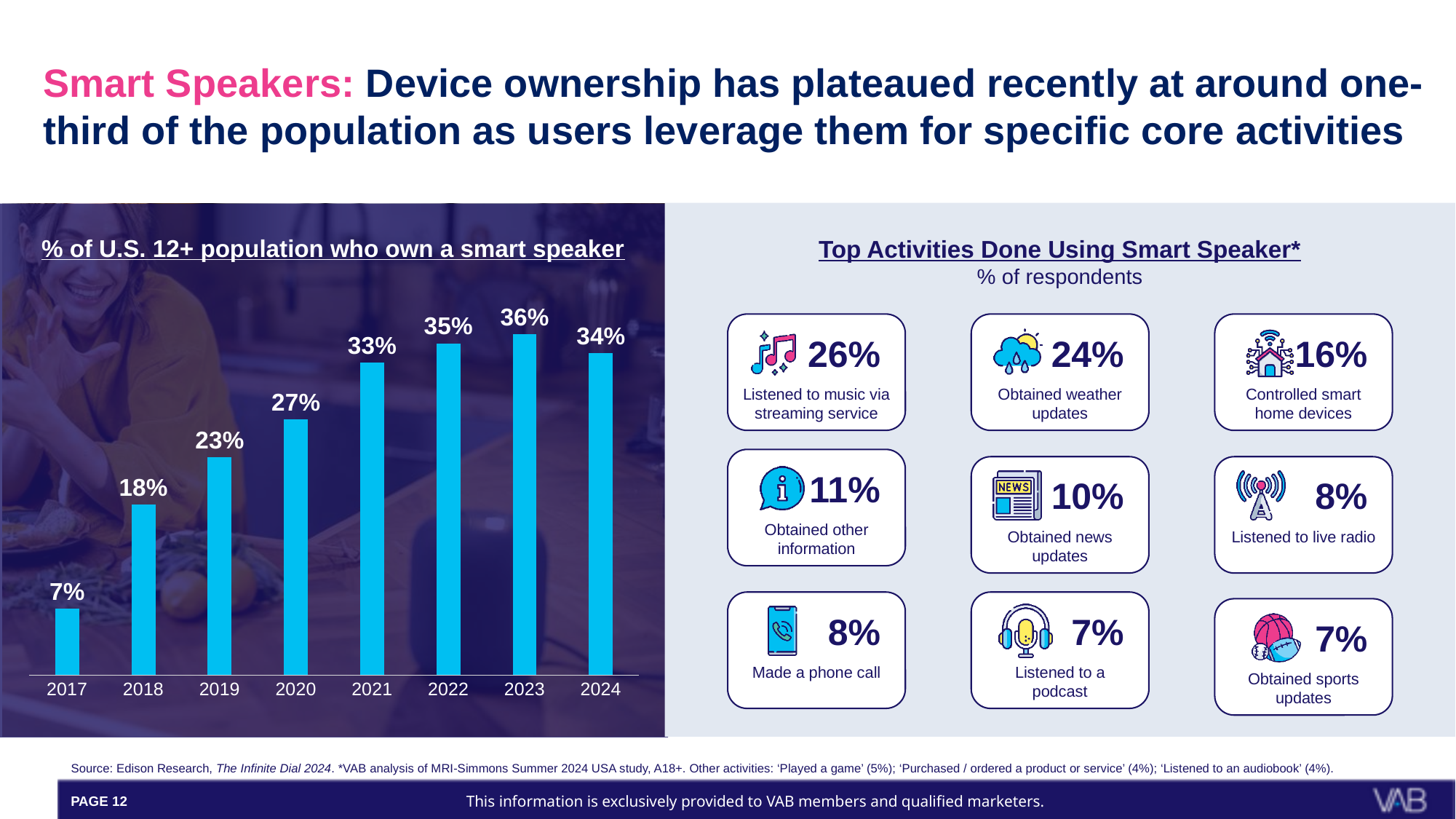
What colour are the bars in the chart '% of U.S. 12+ population who own a smart speaker'? Light blue In the chart '% of U.S. 12+ population who own a smart speaker', what is the difference between the 2018 and 2019 values? 5% In the chart '% of U.S. 12+ population who own a smart speaker', what is the difference between the 2023 and 2017 values? 29% How many years are shown in the chart '% of U.S. 12+ population who own a smart speaker'? 8 In the chart '% of U.S. 12+ population who own a smart speaker', which is larger, the value for 2019 or the value for 2021? 2021 In the chart '% of U.S. 12+ population who own a smart speaker', do the values rise or fall from 2017 to 2023? Rise What kind of chart is '% of U.S. 12+ population who own a smart speaker'? Bar chart In the chart '% of U.S. 12+ population who own a smart speaker', what is the value for 2020? 27% In the chart '% of U.S. 12+ population who own a smart speaker', what is the value for 2022? 35% In the chart '% of U.S. 12+ population who own a smart speaker', which year has the highest value? 2023 In the chart '% of U.S. 12+ population who own a smart speaker', what is the value for 2024? 34% In the chart '% of U.S. 12+ population who own a smart speaker', which year has the lowest value? 2017